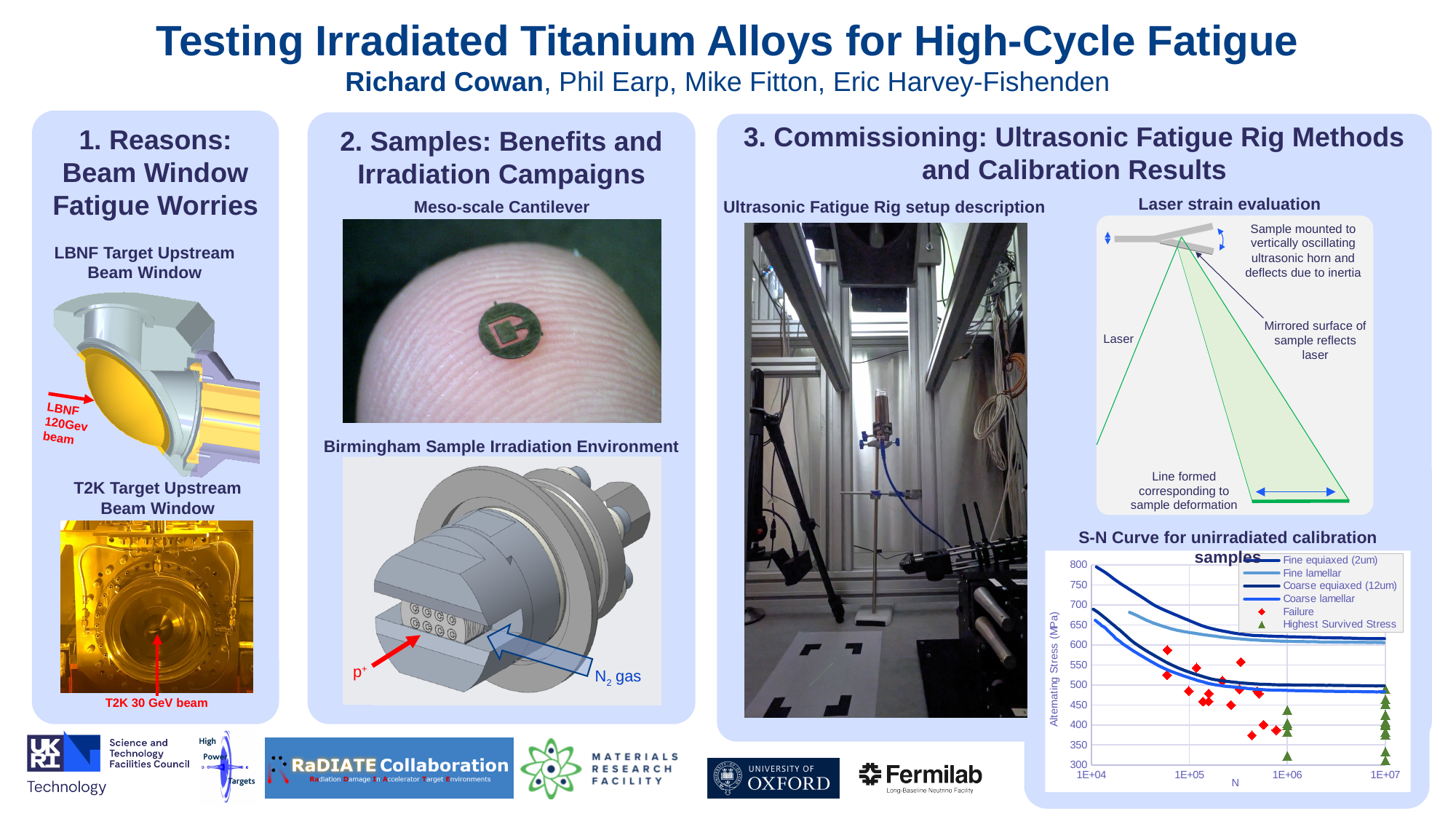
In the S-N Curve chart, which curve is higher at 1E+04: Fine equiaxed (2um) or Coarse lamellar? Fine equiaxed (2um) In the S-N Curve chart, are the Failure markers greater or less than 650 MPa? less In the S-N Curve chart, what marker represents Failure? red diamond What is the y-axis label of the S-N Curve chart? Alternating Stress (MPa) How many material curves (excluding the marker series) are plotted in the S-N Curve chart? 4 In the S-N Curve chart, do the material curves rise or fall as N increases? fall What kind of chart is the S-N Curve for unirradiated calibration samples? line chart In the S-N Curve chart, are the Highest Survived Stress markers greater or less than 550 MPa? less In the S-N Curve chart, is the Fine lamellar curve at 1E+07 greater or less than 550 MPa? greater How many series does the legend of the S-N Curve chart list? 6